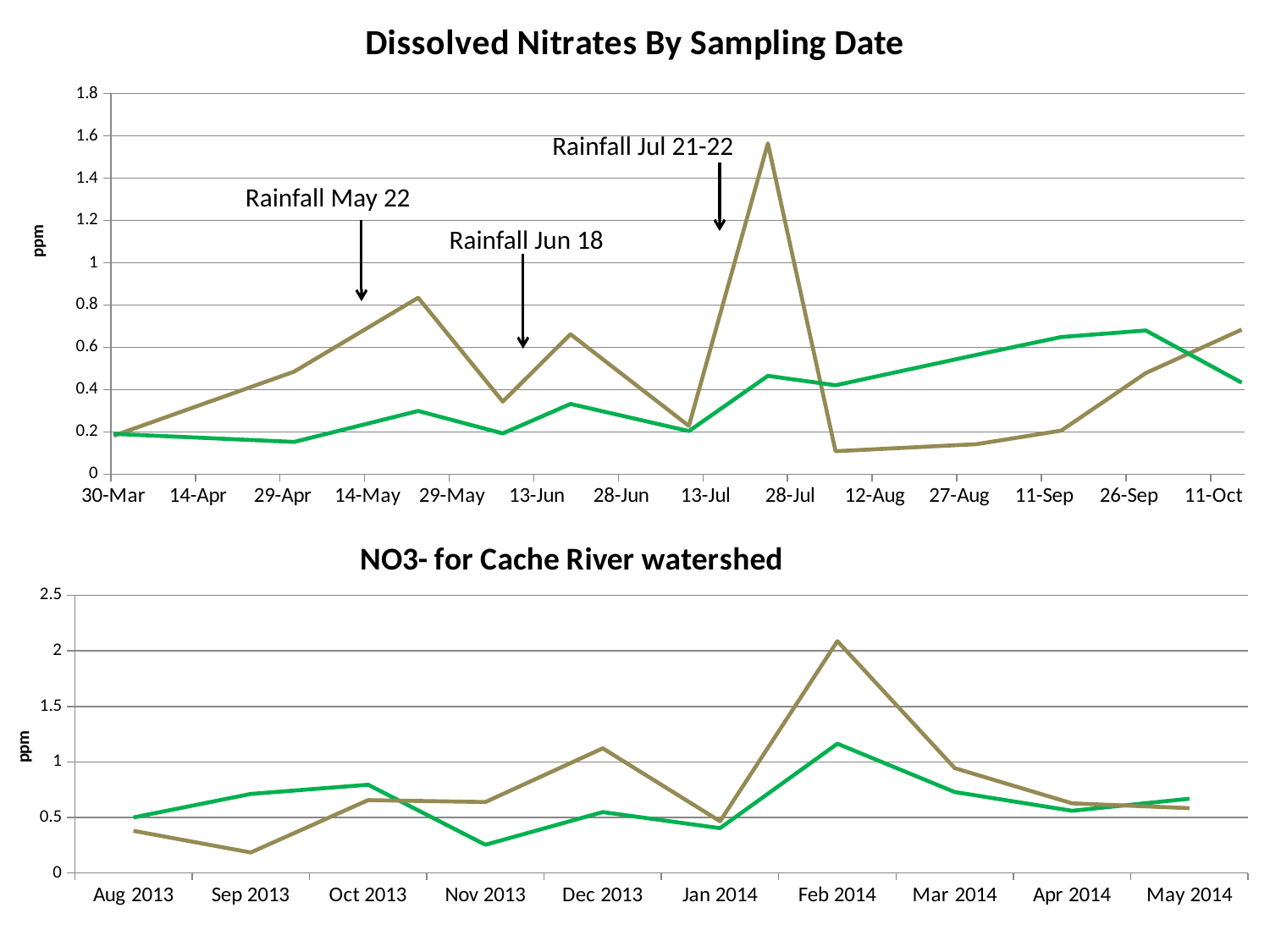
In the top chart, 'Dissolved Nitrates By Sampling Date', is the brown line's value at 12-Aug greater or less than 0.2? less In the bottom chart, 'NO3- for Cache River watershed', does the brown line rise or fall from Feb 2014 to Apr 2014? fall In the bottom chart, 'NO3- for Cache River watershed', at which month does the brown line reach its highest value? Feb 2014 In the bottom chart, 'NO3- for Cache River watershed', at which month is the brown line at its lowest value? Sep 2013 How many rainfall events are annotated with arrows on the top chart, 'Dissolved Nitrates By Sampling Date'? 3 What kind of chart is the top chart, 'Dissolved Nitrates By Sampling Date'? line chart In the top chart, 'Dissolved Nitrates By Sampling Date', how many date ticks are shown on the x axis? 14 In the top chart, 'Dissolved Nitrates By Sampling Date', is the highest point of the brown line greater or less than 1.4? greater In the bottom chart, 'NO3- for Cache River watershed', which line is higher at Dec 2013, the brown line or the green line? brown line In the bottom chart, 'NO3- for Cache River watershed', is the brown line's value at Sep 2013 greater or less than 0.5? less In the bottom chart, 'NO3- for Cache River watershed', how many months are shown on the x axis? 10